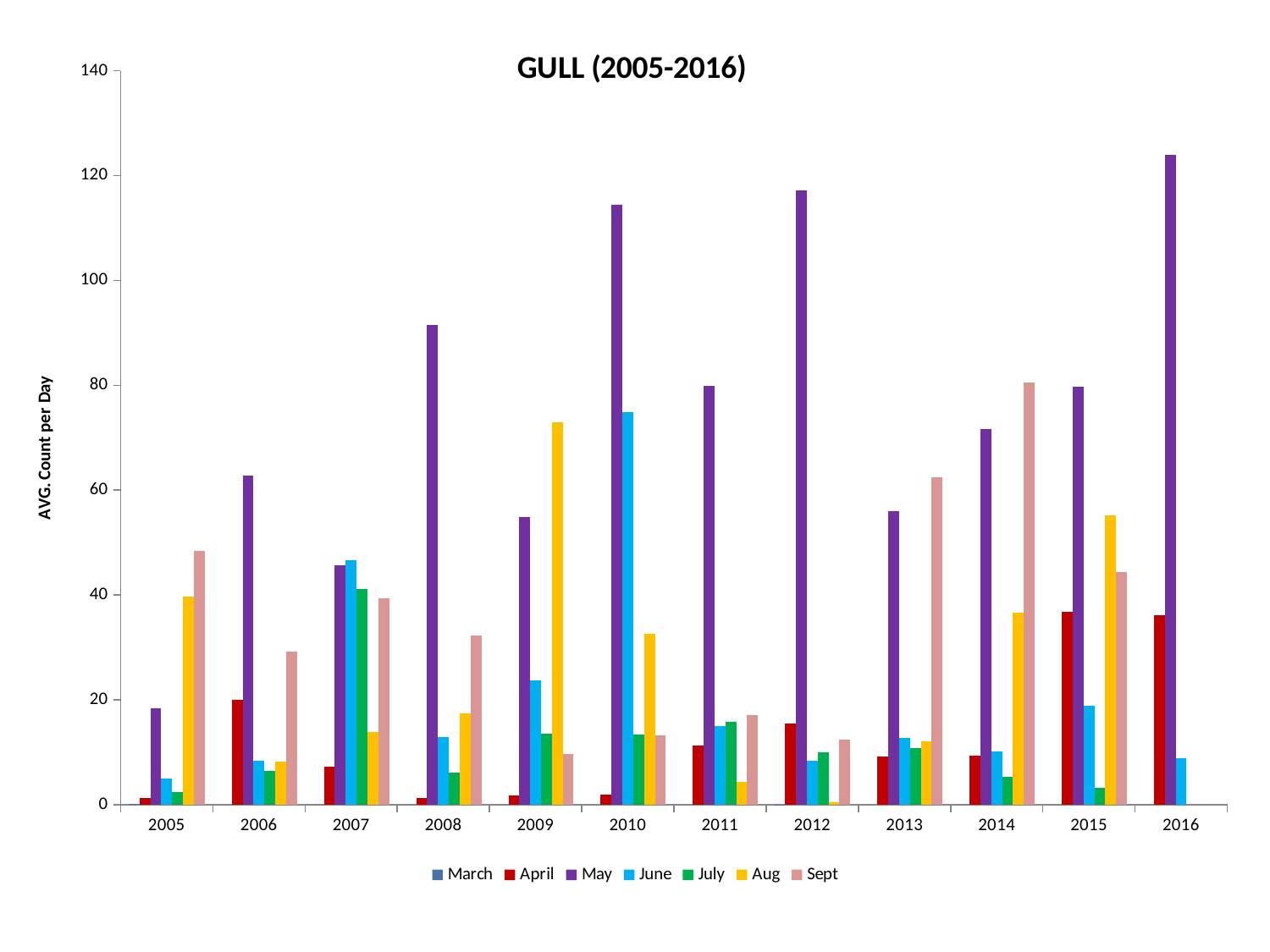
What kind of chart is shown on the slide? Bar chart In which year is the May value highest? 2016 Which month has the tallest bar in 2009? Aug Which is larger, the May value for 2010 or the May value for 2011? 2010 In which year is the May value lowest? 2005 Is the May value for 2016 greater or less than 120? greater What is the title of the chart? GULL (2005-2016) What is the label on the vertical axis? AVG. Count per Day How many series does the legend list? 7 Is the May value for 2012 greater or less than 100? greater Is the Aug value for 2009 greater or less than 60? greater How many years are shown along the x axis? 12